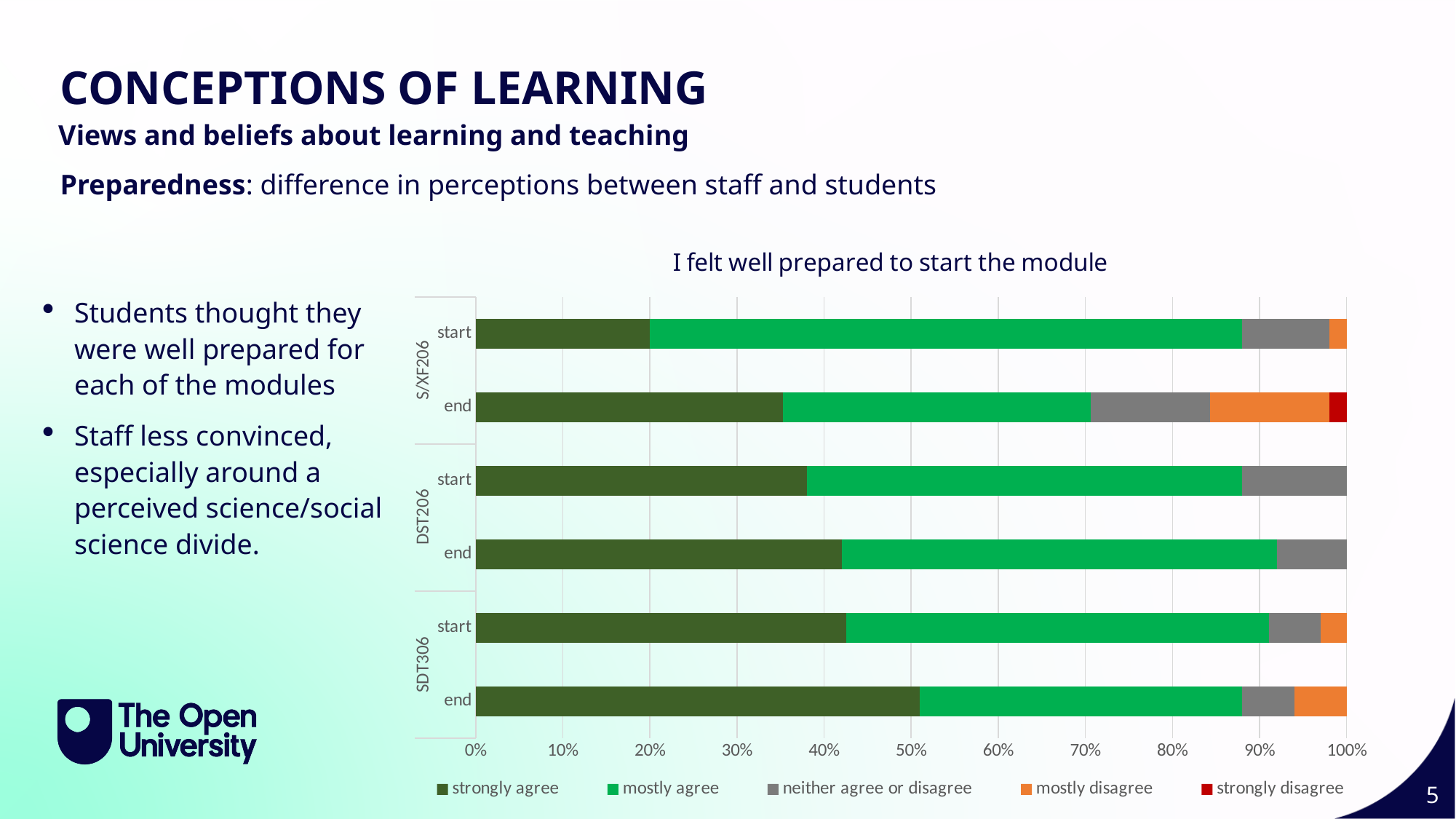
What is the title of the chart? I felt well prepared to start the module What kind of chart is shown on the slide? Stacked bar chart Which legend entry is shown in red? strongly disagree Is the 'strongly agree' share for S/XF206 end greater or less than 30%? greater Is the 'strongly agree' share for DST206 start greater or less than 40%? less Which bar is the only one that includes a 'strongly disagree' segment? S/XF206 end How many series does the legend list? 5 How many bars are plotted in the chart? 6 Which bar has the largest 'strongly agree' segment? SDT306 end Which has a larger 'strongly agree' share, S/XF206 end or DST206 end? DST206 end Which bar has the smallest 'strongly agree' segment? S/XF206 start Is the 'strongly agree' share for SDT306 end greater or less than 40%? greater